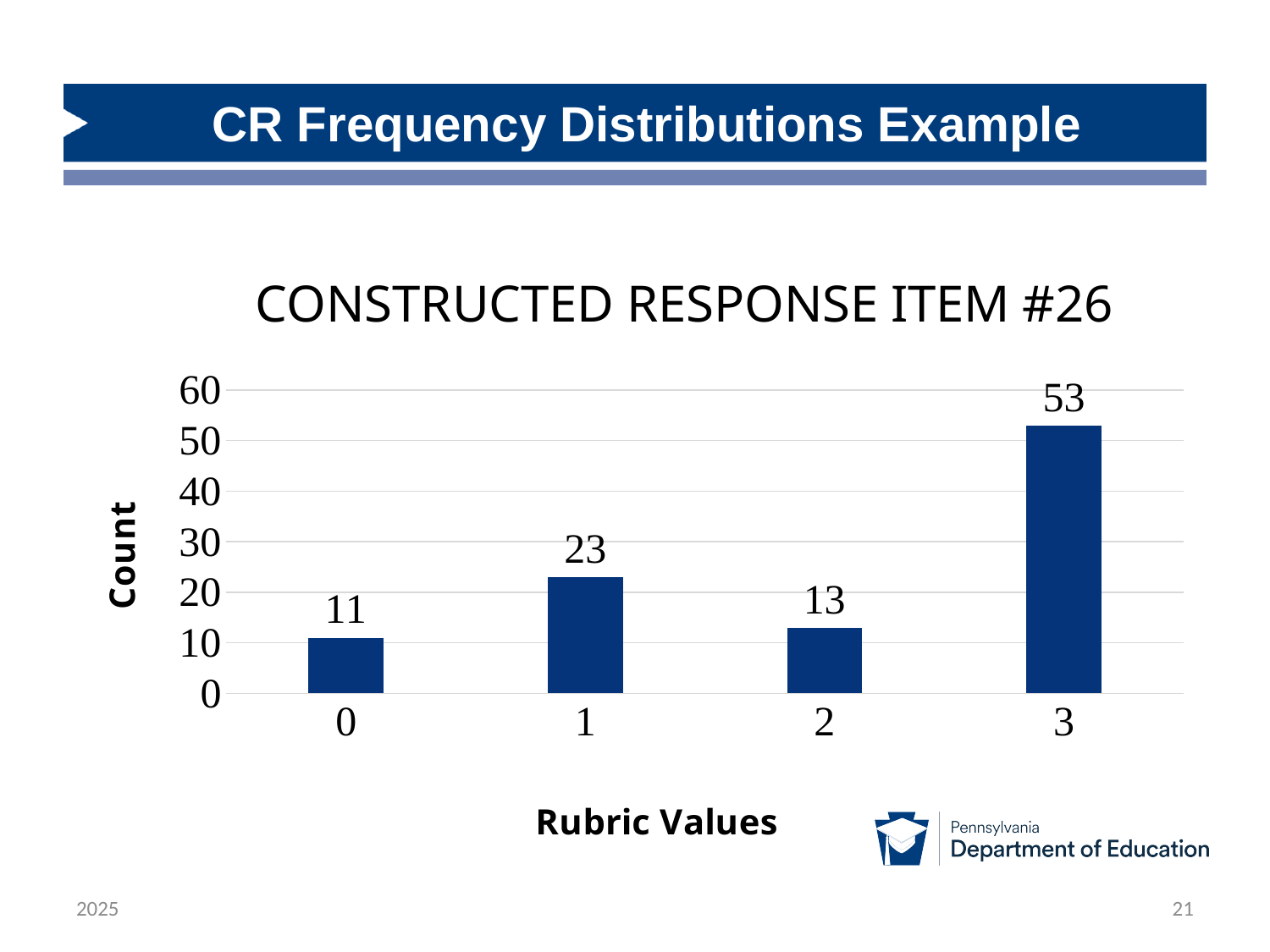
What is the difference between the counts for rubric values 2 and 0? 2 Is the count for rubric value 3 greater or less than 50? greater What kind of chart is shown on the slide? Bar chart Which has a larger count, rubric value 1 or rubric value 2? Rubric value 1 What is the difference between the counts for rubric values 3 and 1? 30 What is the count for rubric value 0? 11 How many rubric value categories are shown in the chart? 4 Which rubric value has the highest count? 3 What is the count for rubric value 3? 53 Which rubric value has the lowest count? 0 What is the title of the chart? CONSTRUCTED RESPONSE ITEM #26 What is the count for rubric value 1? 23